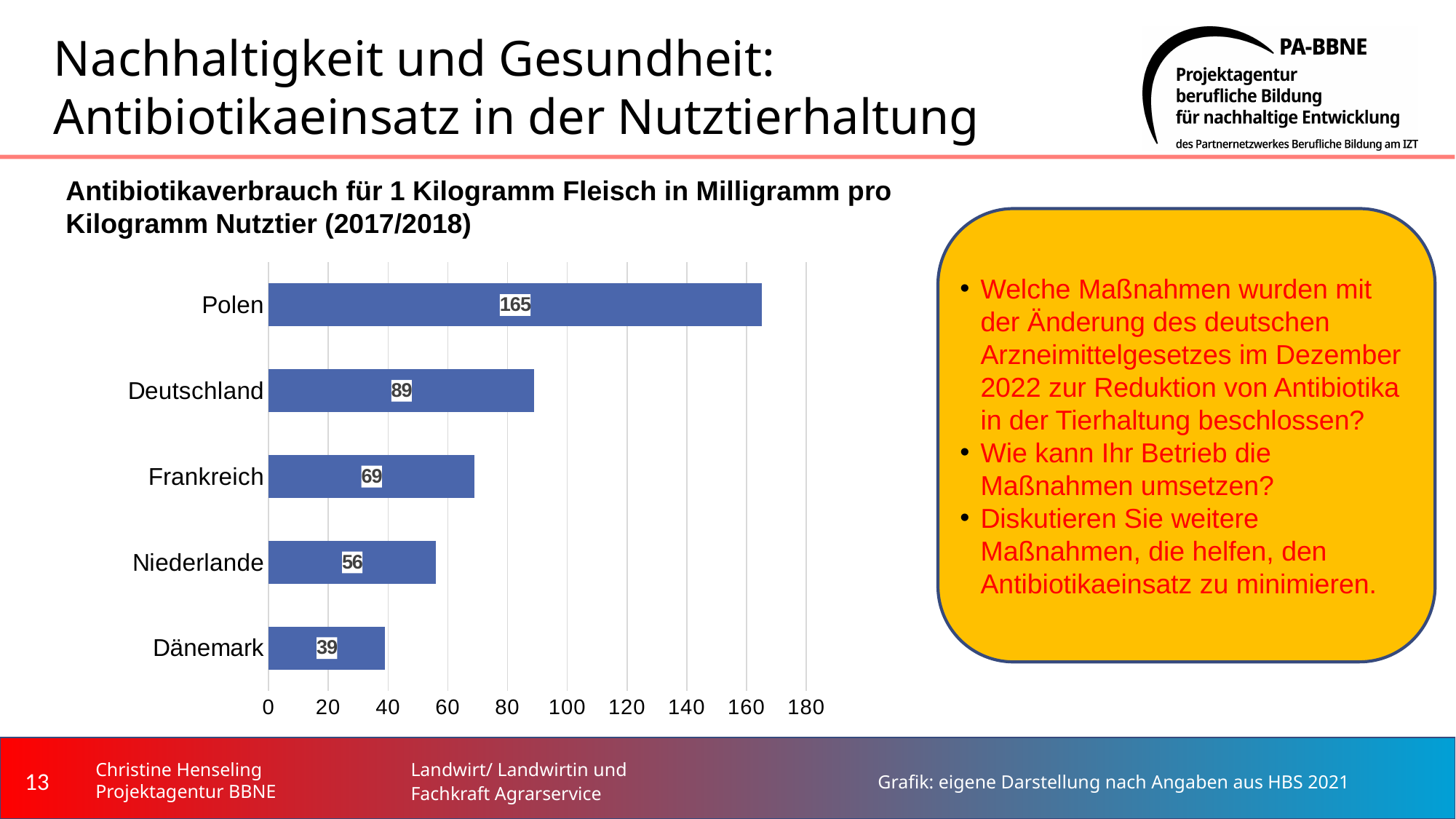
Is the value for Deutschland greater or less than 80? greater What is the value for Niederlande? 56 What is the difference between the values for Polen and Deutschland? 76 Which is larger, the value for Frankreich or the value for Niederlande? Frankreich What is the value for Polen? 165 What is the difference between the values for Frankreich and Dänemark? 30 Which country has the lowest antibiotic consumption? Dänemark Which country has the highest antibiotic consumption? Polen How many countries are shown in the chart? 5 What kind of chart is shown on the slide? bar chart What is the title of the chart? Antibiotikaverbrauch für 1 Kilogramm Fleisch in Milligramm pro Kilogramm Nutztier (2017/2018) What is the value for Deutschland? 89